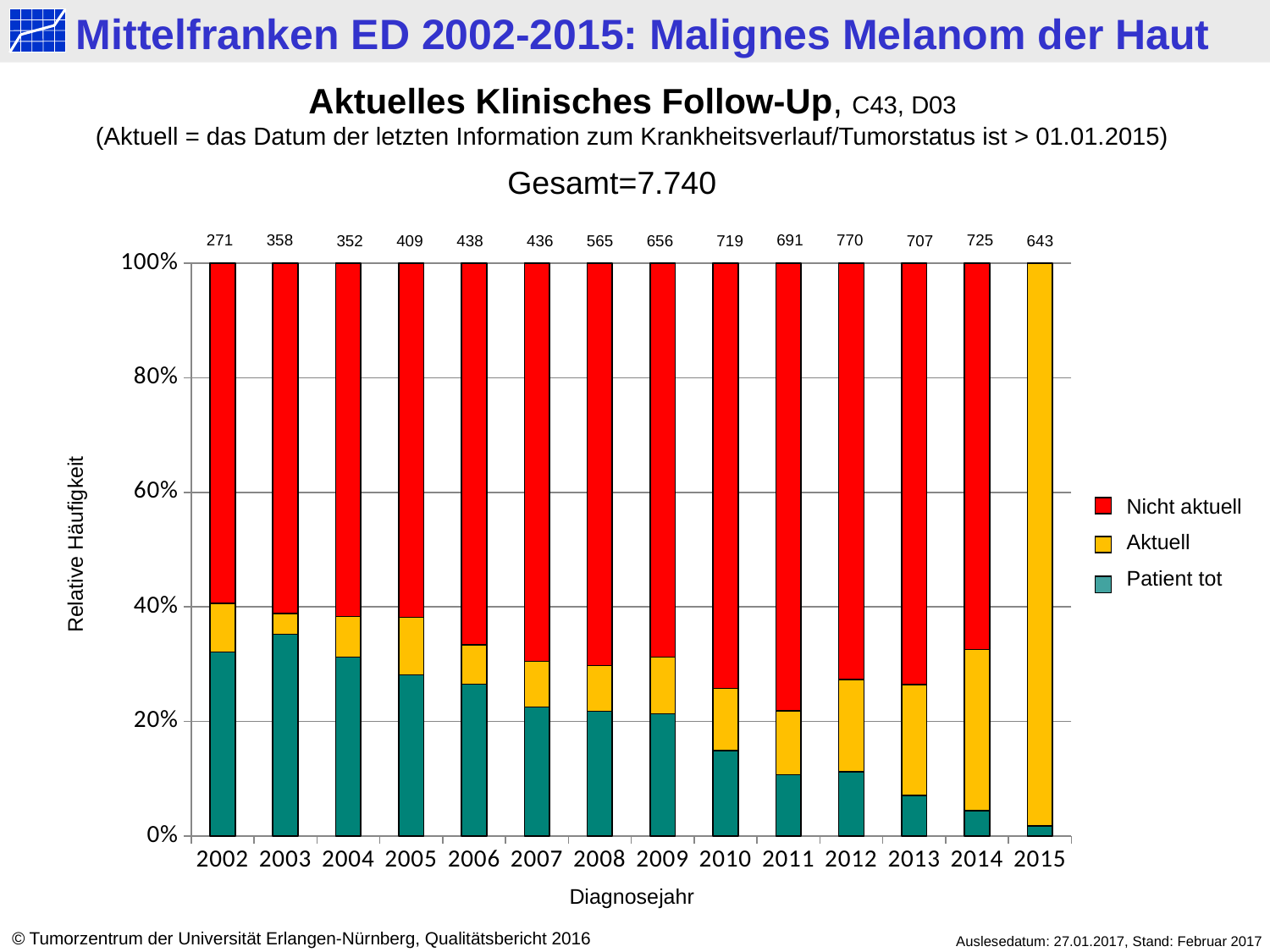
Is the 'Patient tot' share for 2015 greater or less than 20%? less Which diagnosis year has the lowest number of cases printed above its bar? 2002 What is the number of cases printed above the bar for 2002? 271 Which diagnosis year has the highest number of cases printed above its bar? 2012 How many series does the legend list? 3 How many diagnosis years are shown on the x axis? 14 Is the 'Patient tot' share for 2002 greater or less than 20%? greater What is the number of cases printed above the bar for 2012? 770 What is the difference between the case counts printed for 2012 and 2002? 499 What is the number of cases printed above the bar for 2015? 643 What kind of chart is shown on the slide? Stacked bar chart Which year has more cases printed above its bar, 2008 or 2009? 2009